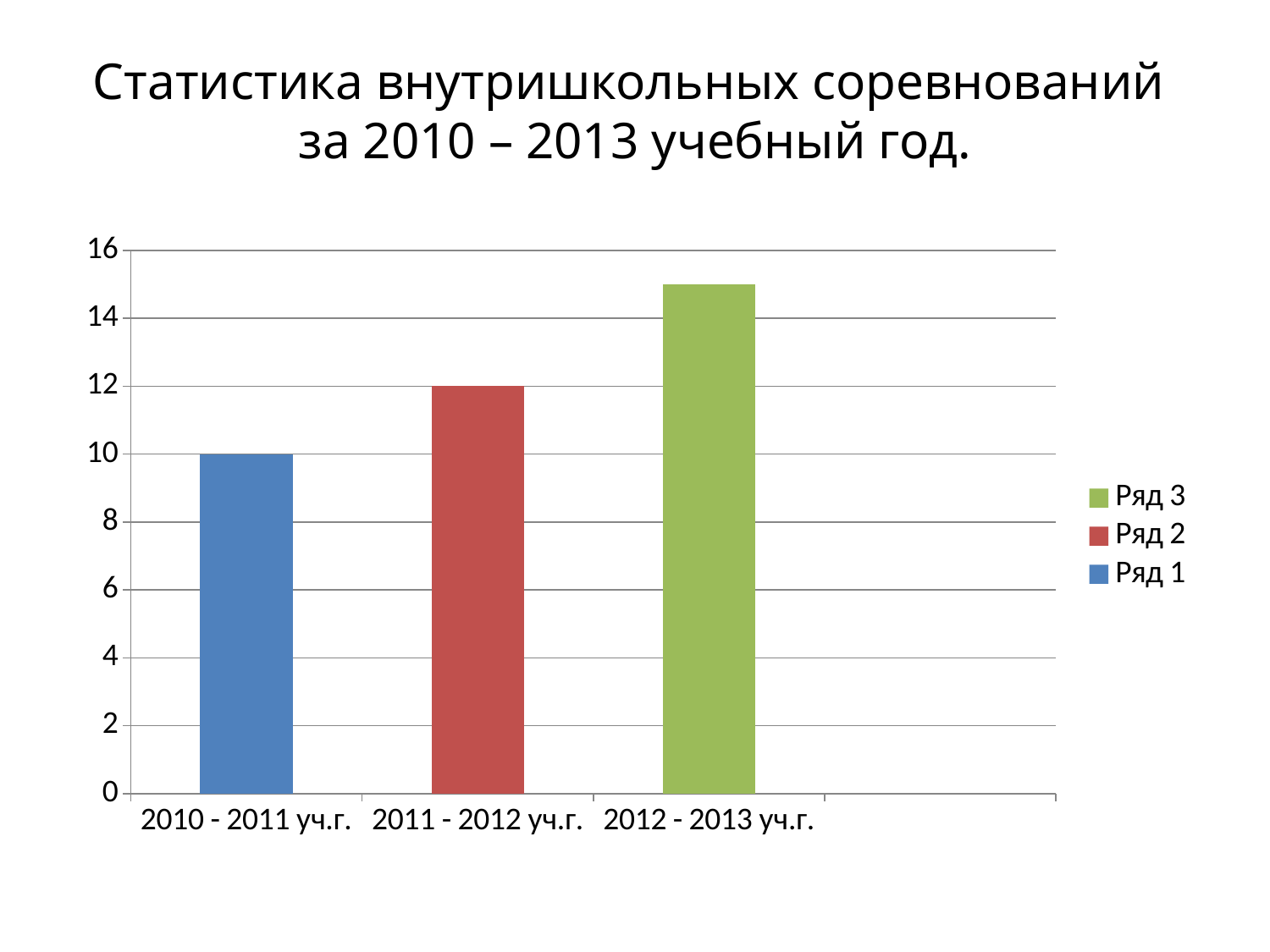
How many series does the legend list? 3 What is the difference between the values for 2011 - 2012 уч.г. and 2010 - 2011 уч.г.? 2 Which category has the lowest bar? 2010 - 2011 уч.г. Do the values rise or fall from 2010 - 2011 уч.г. to 2012 - 2013 уч.г.? rise Which category has the highest bar? 2012 - 2013 уч.г. What kind of chart is shown on the slide? bar chart How many categories are shown on the x axis? 3 Which is larger, the value for 2012 - 2013 уч.г. or the value for 2011 - 2012 уч.г.? 2012 - 2013 уч.г. What is the value for 2010 - 2011 уч.г.? 10 What colour is the bar for 2012 - 2013 уч.г.? green What is the value for 2011 - 2012 уч.г.? 12 Is the value for 2012 - 2013 уч.г. greater or less than 14? greater